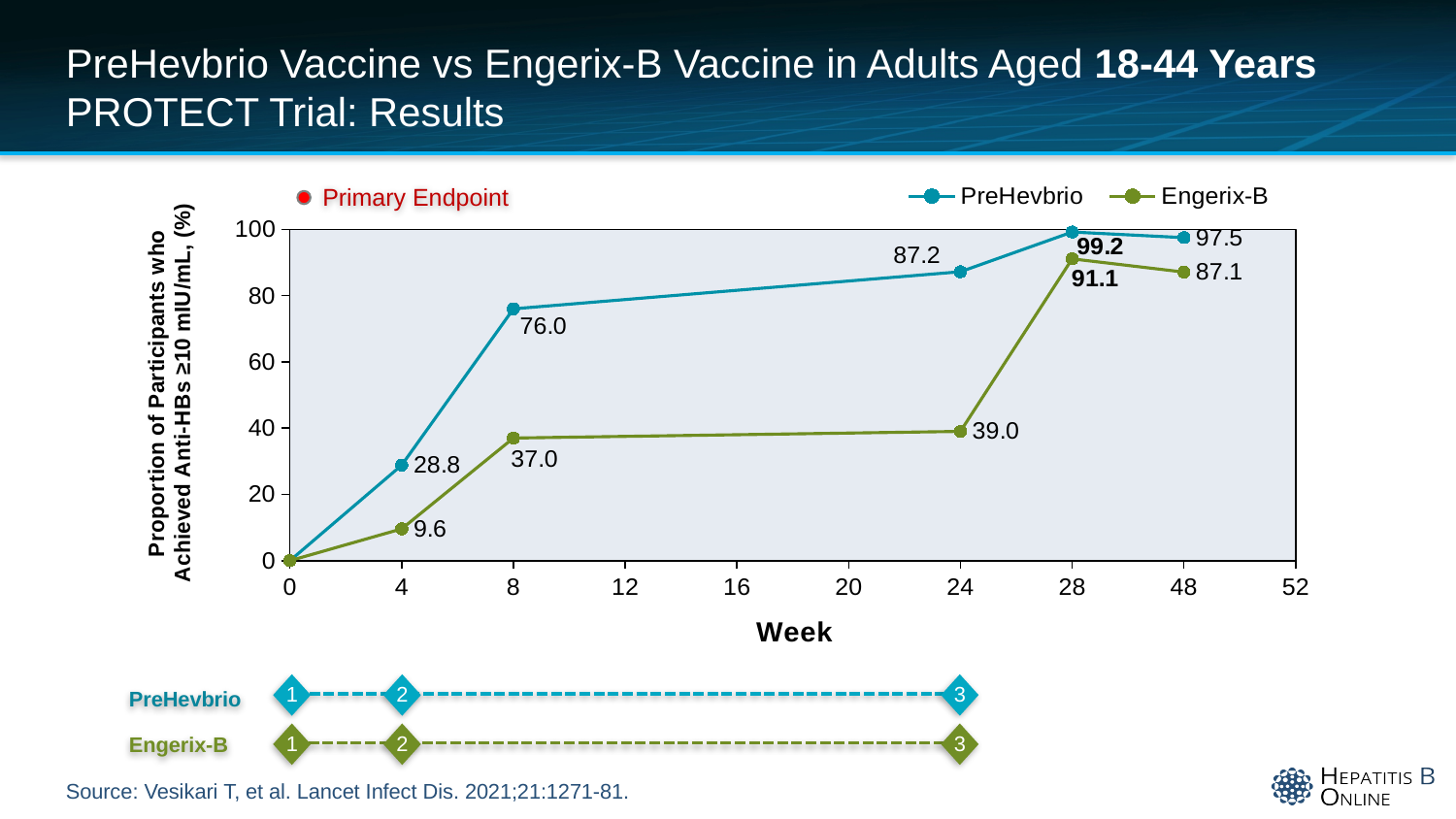
What is the difference between PreHevbrio and Engerix-B at week 28? 8.1 What is the value for Engerix-B at week 4? 9.6 How many series does the chart legend list? 2 Which week is marked as the primary endpoint on the chart? Week 28 At which week does PreHevbrio reach its highest value? Week 28 Does the Engerix-B line rise or fall between week 28 and week 48? Fall What type of chart is shown on the slide? Line chart What is the value for PreHevbrio at week 48? 97.5 What is the value for Engerix-B at week 24? 39.0 What is the value for PreHevbrio at week 8? 76.0 Which series has the larger value at week 4, PreHevbrio or Engerix-B? PreHevbrio What is the difference between PreHevbrio and Engerix-B at week 8? 39.0